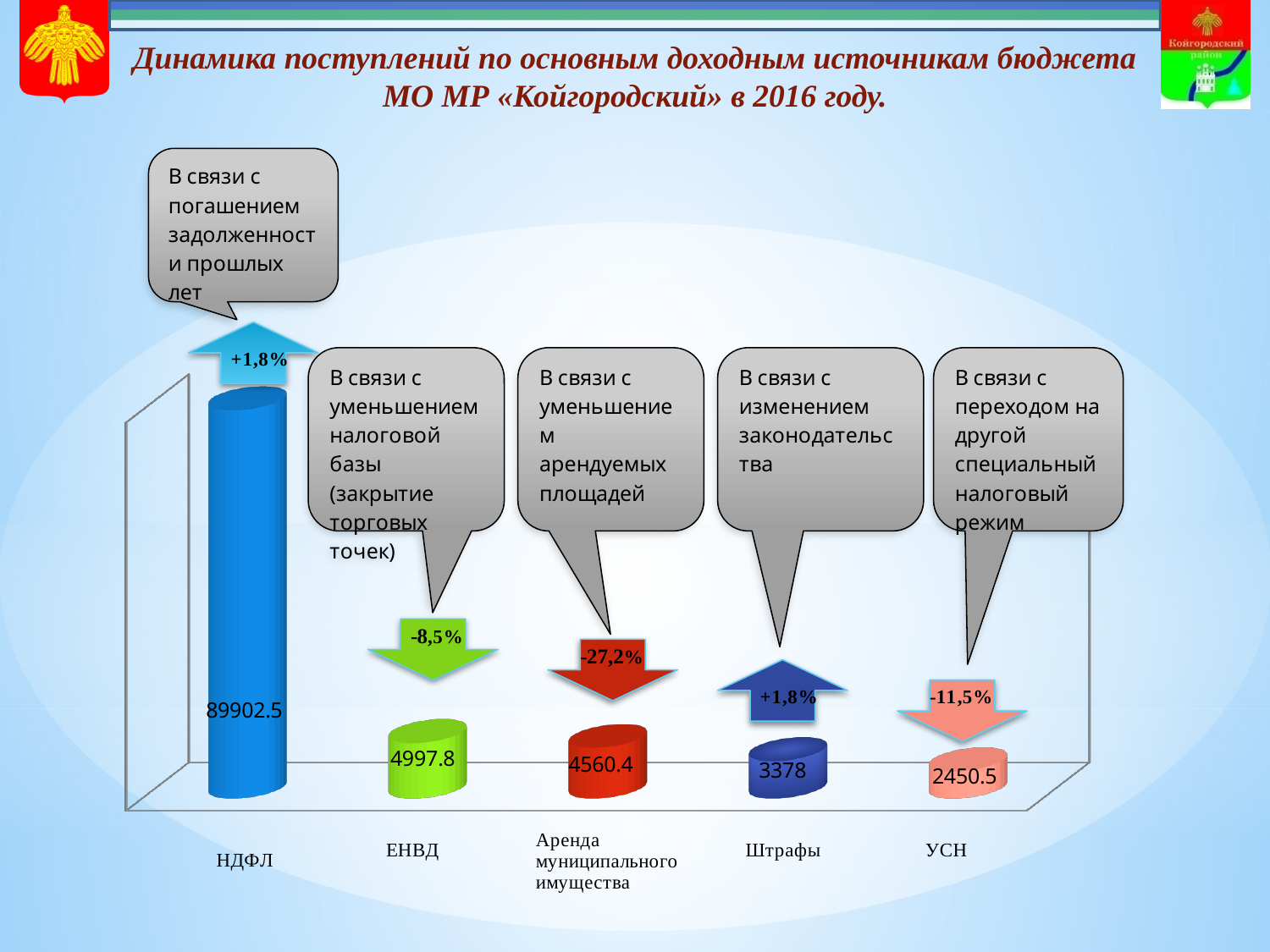
What is the difference between the values for ЕНВД and Аренда муниципального имущества? 437.4 Which category has the highest value? НДФЛ What kind of chart is shown on the slide? bar chart Which is larger, the value for Штрафы or the value for УСН? Штрафы What is the value shown for Аренда муниципального имущества? 4560.4 Which category has the lowest value? УСН What is the value shown for УСН? 2450.5 What is the value shown for ЕНВД? 4997.8 How many categories are shown in the chart? 5 What is the value shown for Штрафы? 3378 What is the value shown for НДФЛ? 89902.5 What percentage change is shown by the arrow above the Аренда муниципального имущества bar? -27,2%